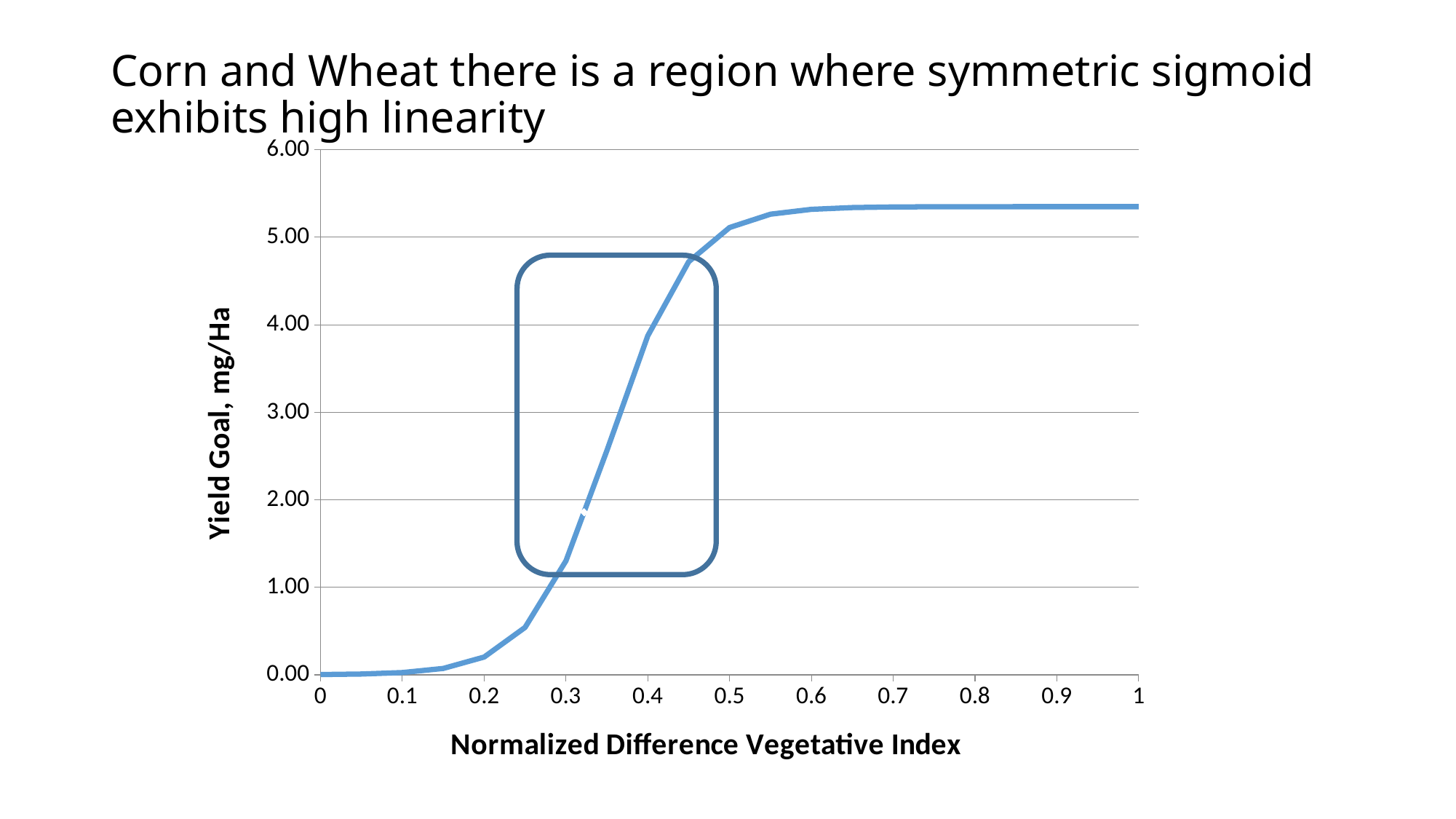
Is the Yield Goal at a Normalized Difference Vegetative Index of 0.3 greater or less than 1.00? greater What is the title of the horizontal axis? Normalized Difference Vegetative Index Is the Yield Goal at a Normalized Difference Vegetative Index of 1 greater or less than 6.00? less Does the Yield Goal rise or fall as the Normalized Difference Vegetative Index increases from 0 to 1? rise Is the Yield Goal at a Normalized Difference Vegetative Index of 0.5 greater or less than 4.00? greater What is the title of the vertical axis? Yield Goal, mg/Ha What kind of chart is shown on the slide? line chart Is the Yield Goal higher at a Normalized Difference Vegetative Index of 0.6 or at 0.3? 0.6